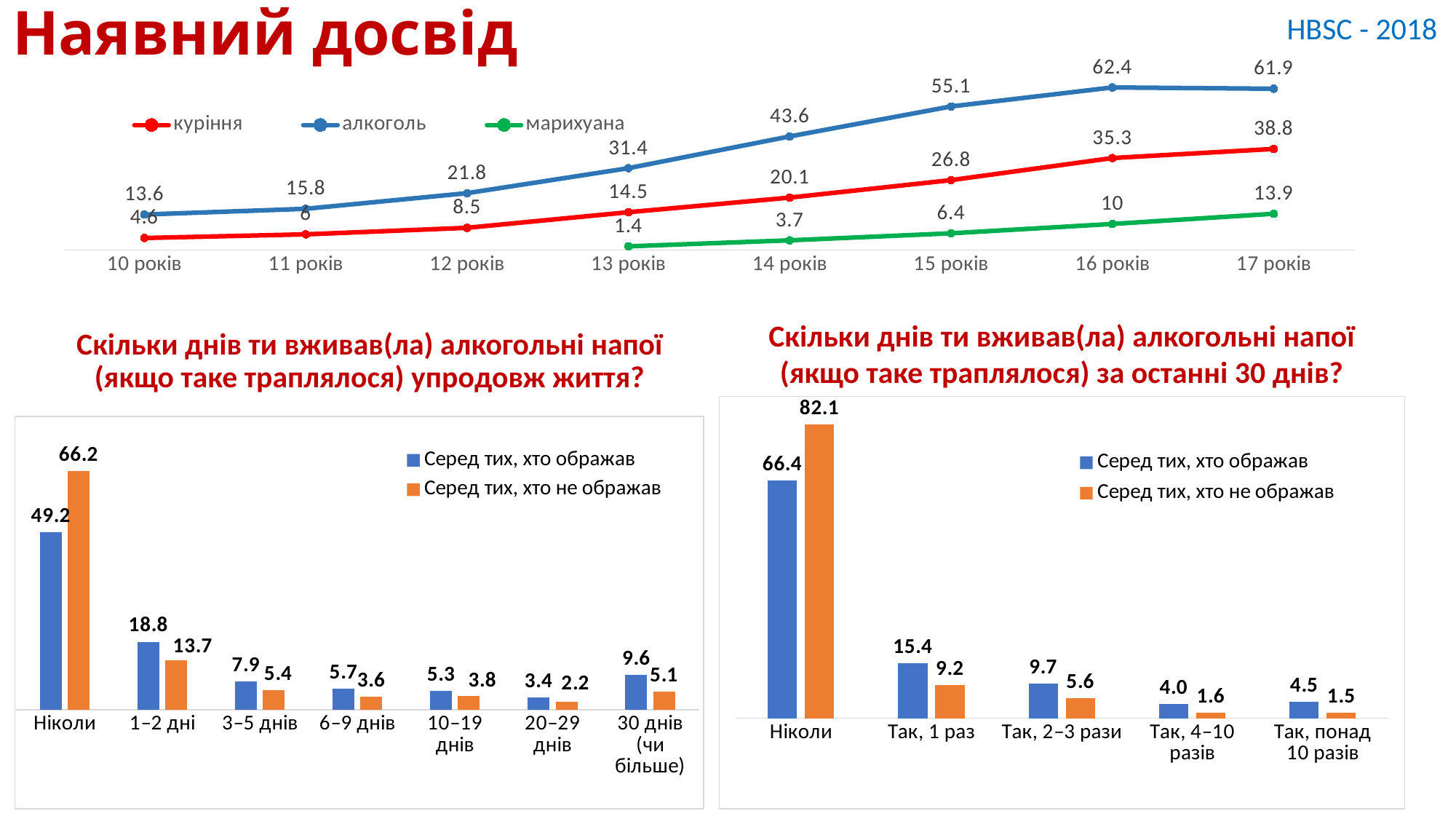
In the chart titled 'Скільки днів ти вживав(ла) алкогольні напої (якщо таке траплялося) за останні 30 днів?', what is the value for 'Серед тих, хто ображав' in the 'Так, 1 раз' category? 15.4 What type of chart is the one titled 'Скільки днів ти вживав(ла) алкогольні напої (якщо таке траплялося) за останні 30 днів?'? bar chart In the top line chart, does the марихуана series rise or fall from 13 років to 17 років? rise In the chart titled 'Скільки днів ти вживав(ла) алкогольні напої (якщо таке траплялося) за останні 30 днів?', what is the difference between the two series in the Ніколи category? 15.7 In the top line chart, how many series does the legend list? 3 In the top line chart, what is the difference between the алкоголь and куріння values at 15 років? 28.3 In the chart titled 'Скільки днів ти вживав(ла) алкогольні напої (якщо таке траплялося) упродовж життя?', how many categories are shown on the x axis? 7 In the chart titled 'Скільки днів ти вживав(ла) алкогольні напої (якщо таке траплялося) упродовж життя?', what is the value for 'Серед тих, хто не ображав' in the Ніколи category? 66.2 In the chart titled 'Скільки днів ти вживав(ла) алкогольні напої (якщо таке траплялося) упродовж життя?', which is larger for '30 днів (чи більше)': 'Серед тих, хто ображав' or 'Серед тих, хто не ображав'? Серед тих, хто ображав In the top line chart, at which age does the алкоголь series reach its highest value? 16 років In the top line chart, what is the value for куріння at 17 років? 38.8 In the top line chart, what is the value for алкоголь at 14 років? 43.6